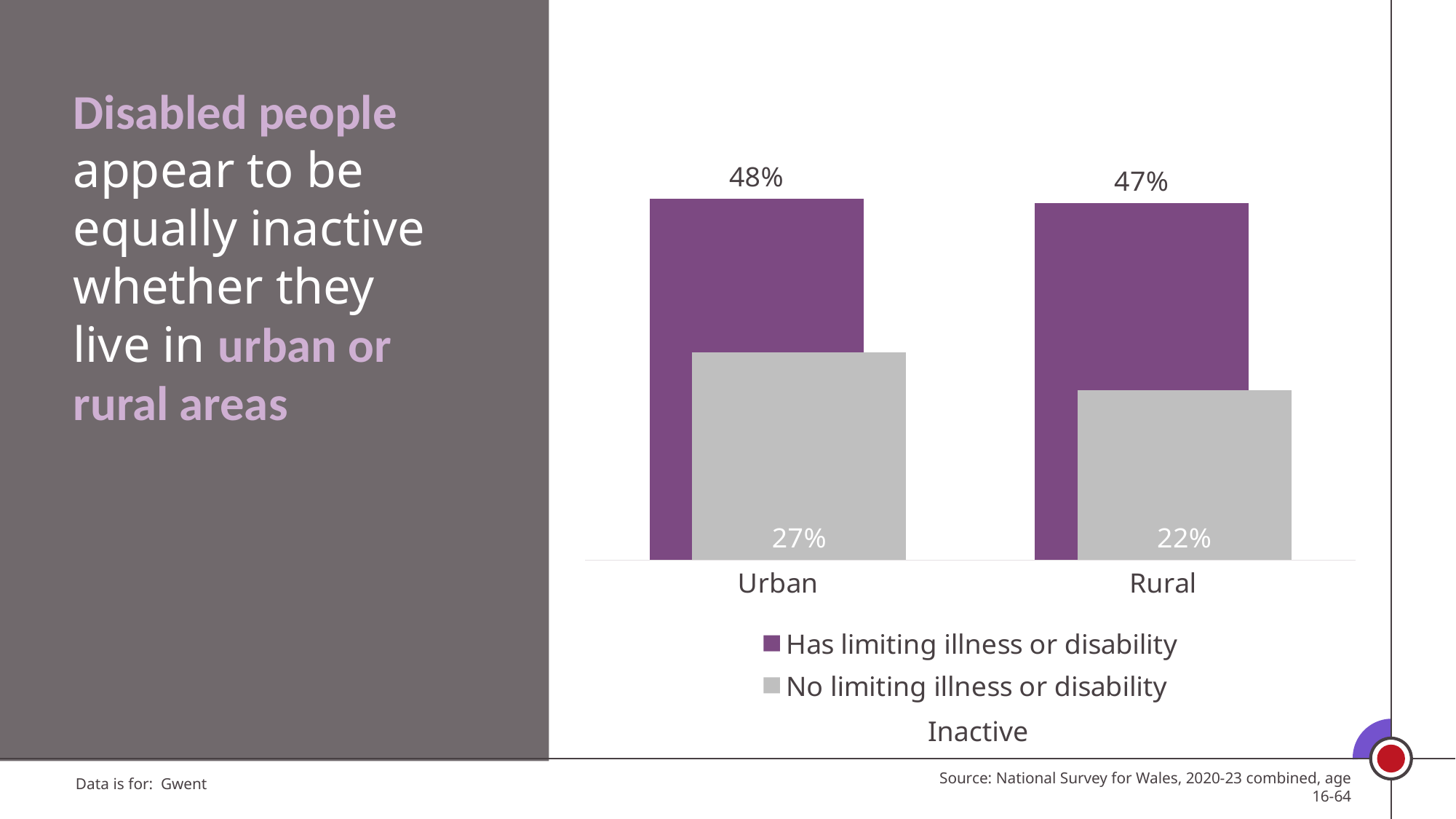
What is the difference between the inactive percentages for people with and without a limiting illness or disability in urban areas? 21% What is the inactive percentage for people with no limiting illness or disability in urban areas? 27% What percentage of people with a limiting illness or disability in urban areas are inactive? 48% Which area has the higher inactive percentage for people with no limiting illness or disability, Urban or Rural? Urban Which series is shown in purple in the chart? Has limiting illness or disability What is the difference between the inactive percentages for people with and without a limiting illness or disability in rural areas? 25% How many series does the chart legend list? 2 How many area categories are shown on the x axis of the chart? 2 What is the inactive percentage for people with no limiting illness or disability in rural areas? 22% What percentage of people with a limiting illness or disability in rural areas are inactive? 47% What type of chart is shown on the slide? Bar chart What is the difference between the urban and rural inactive percentages for people with no limiting illness or disability? 5%